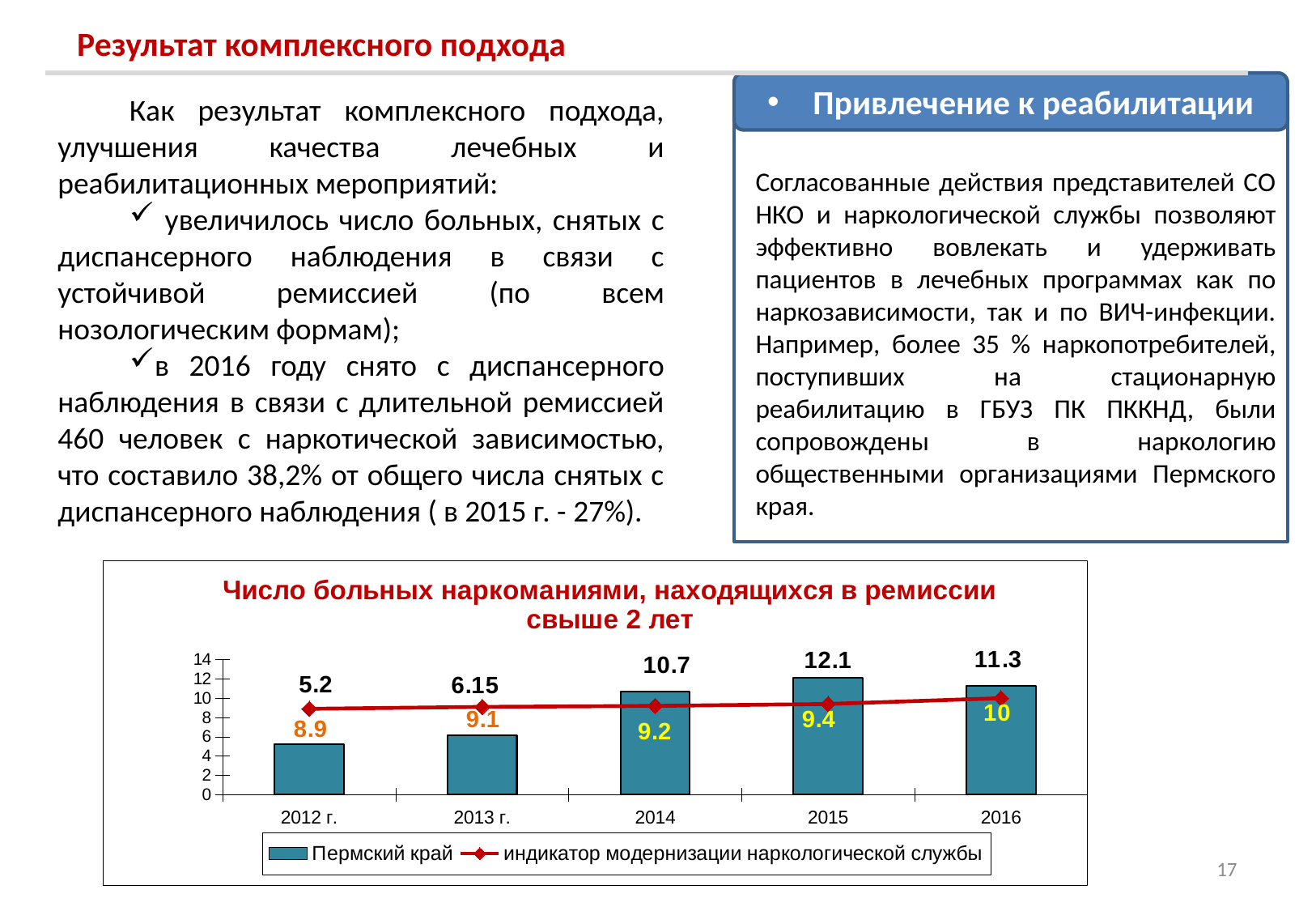
Which is larger in 2014: the Пермский край bar or the индикатор модернизации наркологической службы line? Пермский край bar What is the value of the индикатор модернизации наркологической службы line for 2012 г.? 8.9 In which year is the Пермский край bar highest? 2015 How many years are shown on the x axis? 5 What kind of chart is shown on the slide? Combined bar and line chart How many series does the legend list? 2 Does the индикатор модернизации наркологической службы line rise or fall from 2012 г. to 2016? rise Is the Пермский край value for 2012 г. greater or less than 6? less What is the value of the Пермский край bar for 2013 г.? 6.15 In which year is the Пермский край bar lowest? 2012 г. What is the value of the Пермский край bar for 2015? 12.1 What is the difference between the Пермский край values for 2015 and 2016? 0.8